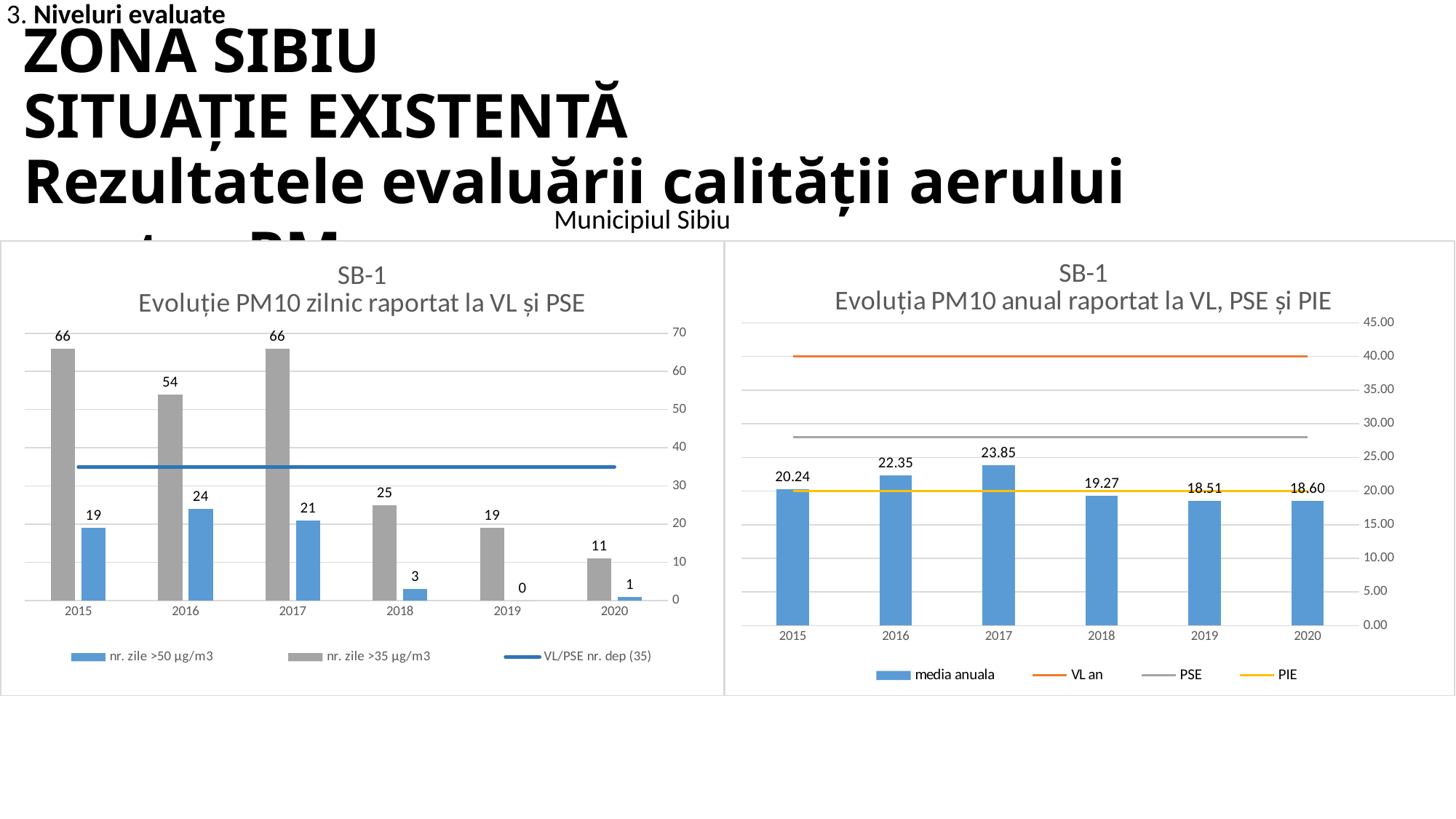
In the right chart (Evoluția PM10 anual raportat la VL, PSE și PIE), what is the media anuala value for 2017? 23.85 In the right chart (Evoluția PM10 anual raportat la VL, PSE și PIE), which year has the lowest media anuala? 2019 In the left chart (Evoluție PM10 zilnic raportat la VL și PSE), how many series does the legend list? 3 In the left chart (Evoluție PM10 zilnic raportat la VL și PSE), what is the value of the gray bar (nr. zile >35 µg/m3) for 2016? 54 In the left chart (Evoluție PM10 zilnic raportat la VL și PSE), what is the difference between the nr. zile >35 µg/m3 values for 2017 and 2020? 55 In the left chart (Evoluție PM10 zilnic raportat la VL și PSE), what is the value of the blue bar (nr. zile >50 µg/m3) for 2018? 3 In the right chart (Evoluția PM10 anual raportat la VL, PSE și PIE), what colour is the PIE line in the legend? Yellow In the left chart (Evoluție PM10 zilnic raportat la VL și PSE), is the nr. zile >35 µg/m3 value for 2018 greater or less than the VL/PSE line at 35? less In the right chart (Evoluția PM10 anual raportat la VL, PSE și PIE), which is larger, the media anuala for 2015 or for 2016? 2016 In the right chart (Evoluția PM10 anual raportat la VL, PSE și PIE), how many years are shown on the x axis? 6 In the left chart (Evoluție PM10 zilnic raportat la VL și PSE), which year has the lowest value for nr. zile >50 µg/m3? 2019 In the right chart (Evoluția PM10 anual raportat la VL, PSE și PIE), is the VL an line greater or less than 35.00? greater